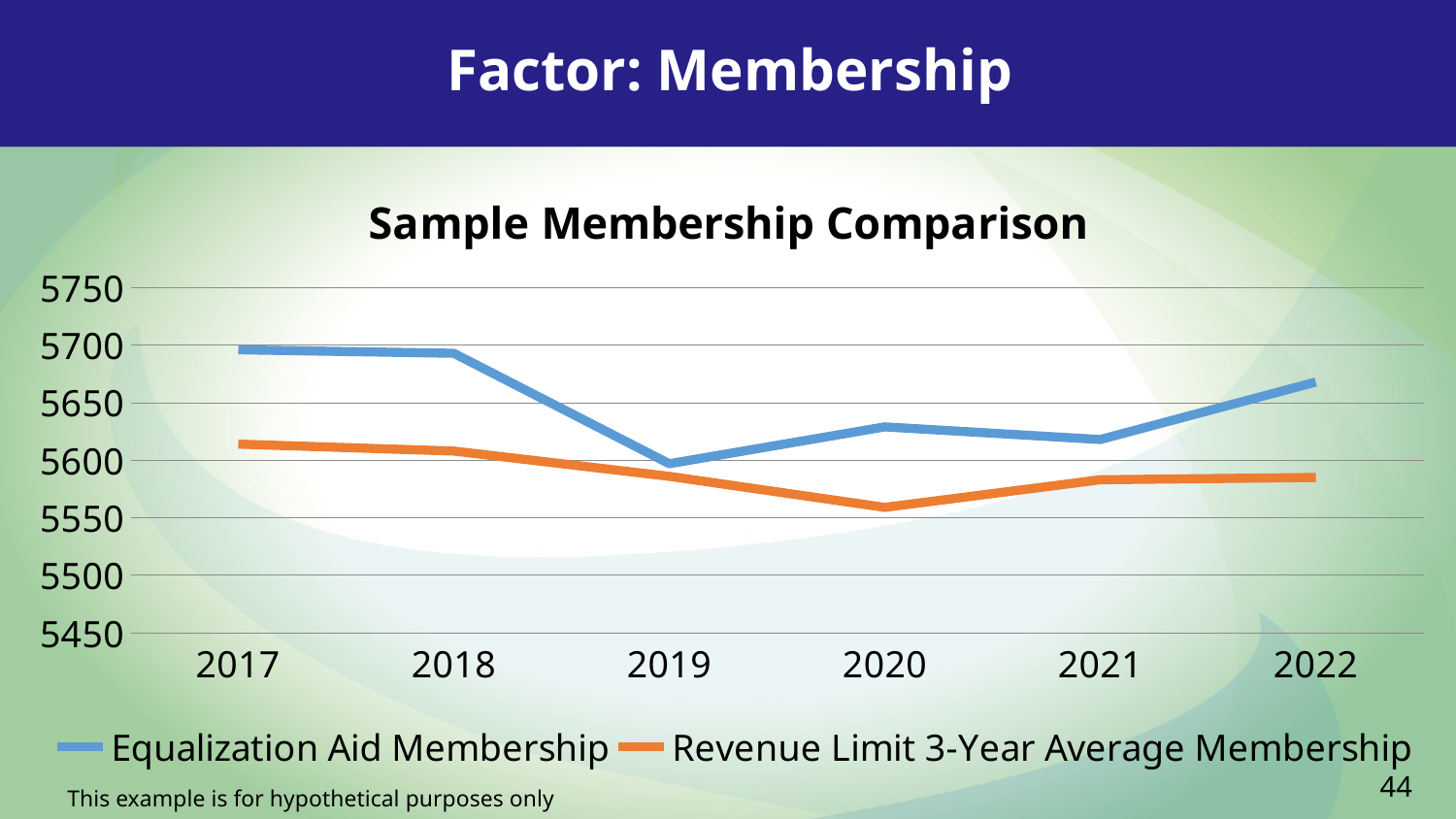
Is Equalization Aid Membership higher in 2019 or in 2022? 2022 How many series does the legend list? 2 Is the Revenue Limit 3-Year Average Membership value for 2020 greater or less than 5600? less How many years are plotted along the x axis? 6 In 2017, which series has the higher value, Equalization Aid Membership or Revenue Limit 3-Year Average Membership? Equalization Aid Membership What kind of chart is shown on the slide? line chart In which year is Revenue Limit 3-Year Average Membership lowest? 2020 In which year is Equalization Aid Membership lowest? 2019 Is the Equalization Aid Membership value for 2022 greater or less than 5650? greater Does Revenue Limit 3-Year Average Membership rise or fall from 2017 to 2020? fall Is the Equalization Aid Membership value for 2017 greater or less than 5650? greater What is the title of the chart? Sample Membership Comparison